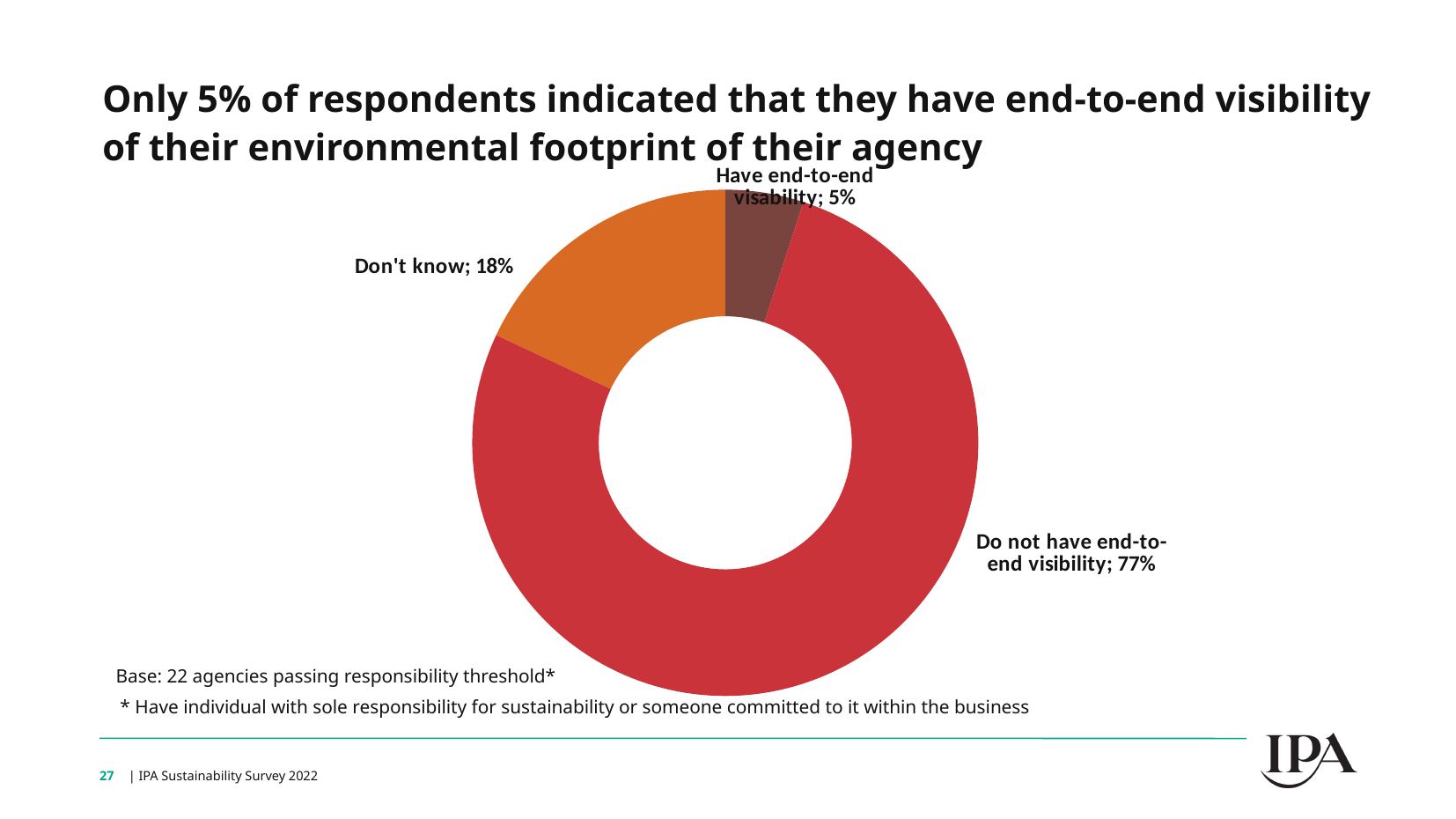
What is the base size stated for the chart? 22 agencies passing responsibility threshold Which is larger: the share for 'Don't know' or the share for 'Have end-to-end visability'? Don't know How many categories are shown in the chart? 3 Which category has the smallest share of the chart? Have end-to-end visability What percentage of respondents do not have end-to-end visibility? 77% What kind of chart is shown on the slide? Doughnut (pie) chart What percentage of respondents have end-to-end visibility? 5% What percentage of respondents answered 'Don't know'? 18% What colour is the 'Don't know' slice? Orange What is the difference in percentage points between 'Don't know' and 'Have end-to-end visability'? 13 What is the difference in percentage points between 'Do not have end-to-end visibility' and 'Don't know'? 59 Which category has the largest share of the chart? Do not have end-to-end visibility